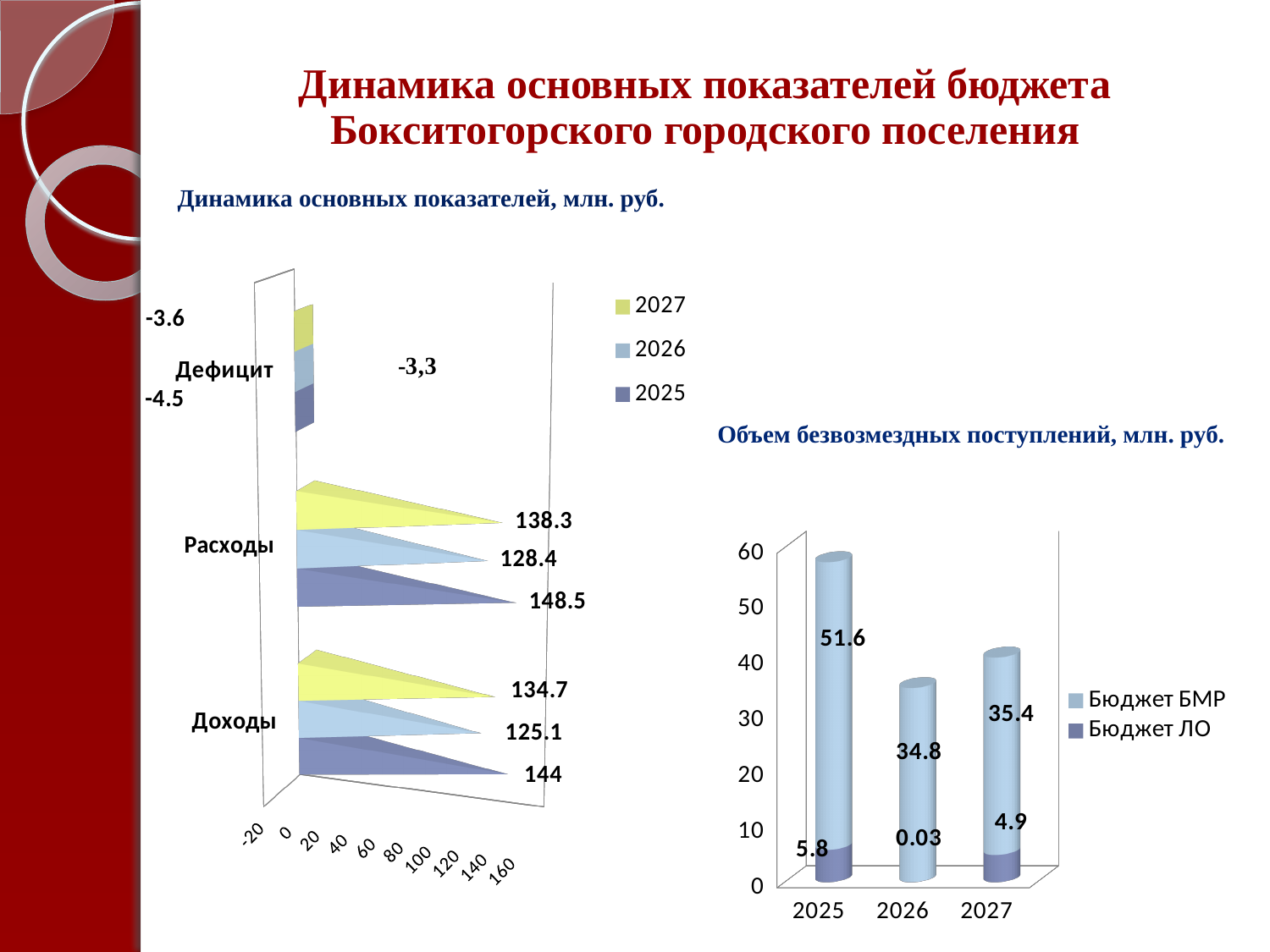
In the chart 'Динамика основных показателей, млн. руб.', how many series does the legend list? 3 In the chart 'Динамика основных показателей, млн. руб.', which year has the highest value for Доходы? 2025 In the chart 'Объем безвозмездных поступлений, млн. руб.', what is the value of Бюджет ЛО for 2026? 0.03 In the chart 'Динамика основных показателей, млн. руб.', what is the value of Доходы for 2026? 125.1 In the chart 'Динамика основных показателей, млн. руб.', what is the difference between Расходы and Доходы for 2027? 3.6 In the chart 'Объем безвозмездных поступлений, млн. руб.', which year has the lowest value for Бюджет ЛО? 2026 In the chart 'Динамика основных показателей, млн. руб.', what is the value of Расходы for 2025? 148.5 In the chart 'Объем безвозмездных поступлений, млн. руб.', what is the value of Бюджет БМР for 2025? 51.6 In the chart 'Динамика основных показателей, млн. руб.', how many categories are shown on the vertical axis? 3 What kind of chart is 'Объем безвозмездных поступлений, млн. руб.'? Stacked bar chart In the chart 'Динамика основных показателей, млн. руб.', what is the value of Дефицит for 2027? -3.6 In the chart 'Объем безвозмездных поступлений, млн. руб.', what is the total of the stacked bar for 2027? 40.3